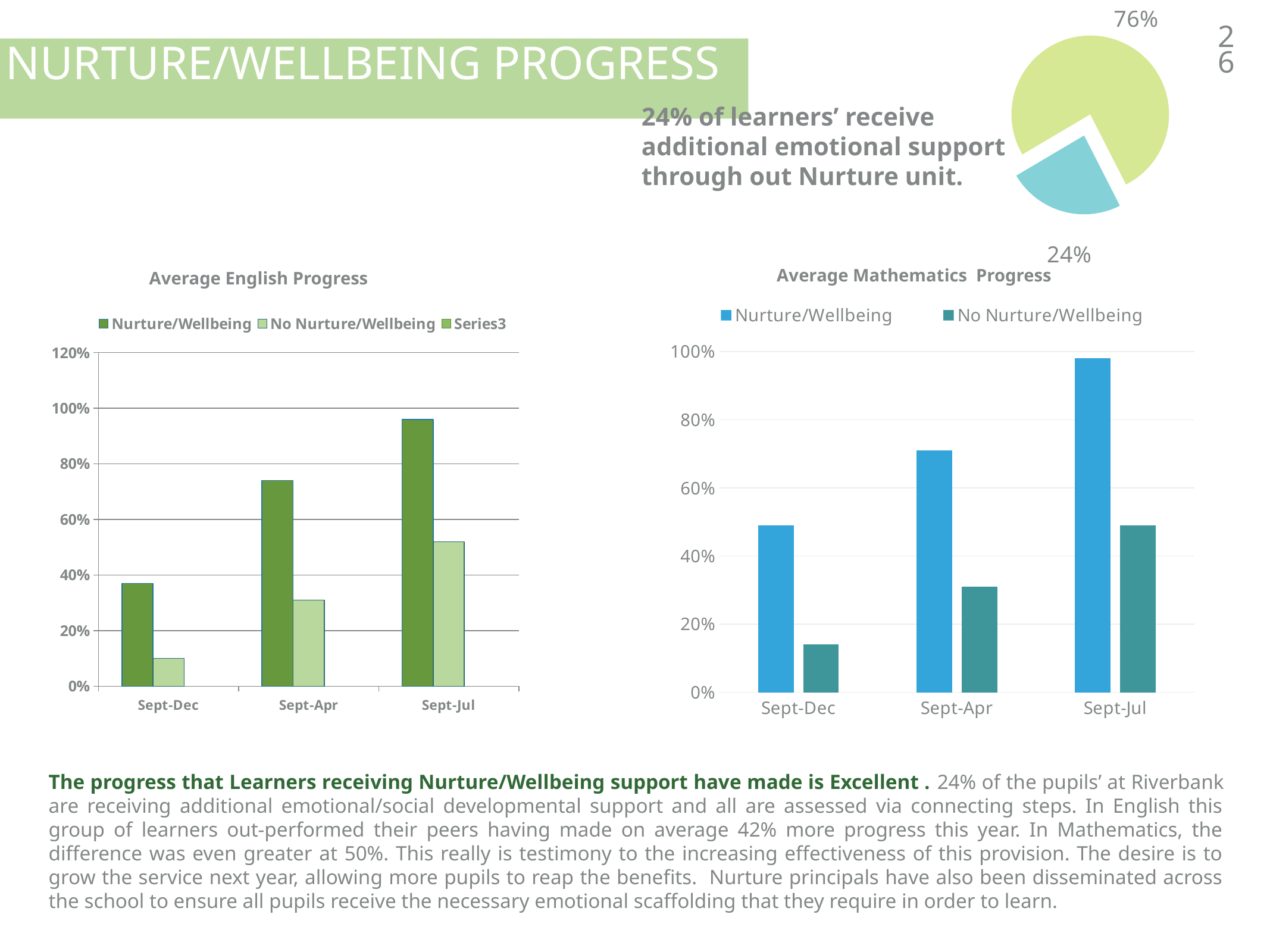
On the Average Mathematics Progress chart, is the Nurture/Wellbeing value for Sept-Jul greater or less than 80%? greater On the Average English Progress chart, for Sept-Apr, which is larger: Nurture/Wellbeing or No Nurture/Wellbeing? Nurture/Wellbeing On the Average Mathematics Progress chart, is the No Nurture/Wellbeing value for Sept-Dec greater or less than 20%? less On the pie chart at the top right, what share does the smaller slice represent? 24% On the Average English Progress chart, is the Nurture/Wellbeing value for Sept-Jul greater or less than 80%? greater On the Average English Progress chart, how many series does the legend list? 3 On the Average Mathematics Progress chart, which category has the highest Nurture/Wellbeing value? Sept-Jul On the Average Mathematics Progress chart, how many series does the legend list? 2 On the Average English Progress chart, do the Nurture/Wellbeing values rise or fall from Sept-Dec to Sept-Jul? rise On the Average Mathematics Progress chart, how many categories are shown on the x axis? 3 What kind of chart is the Average English Progress chart? bar chart